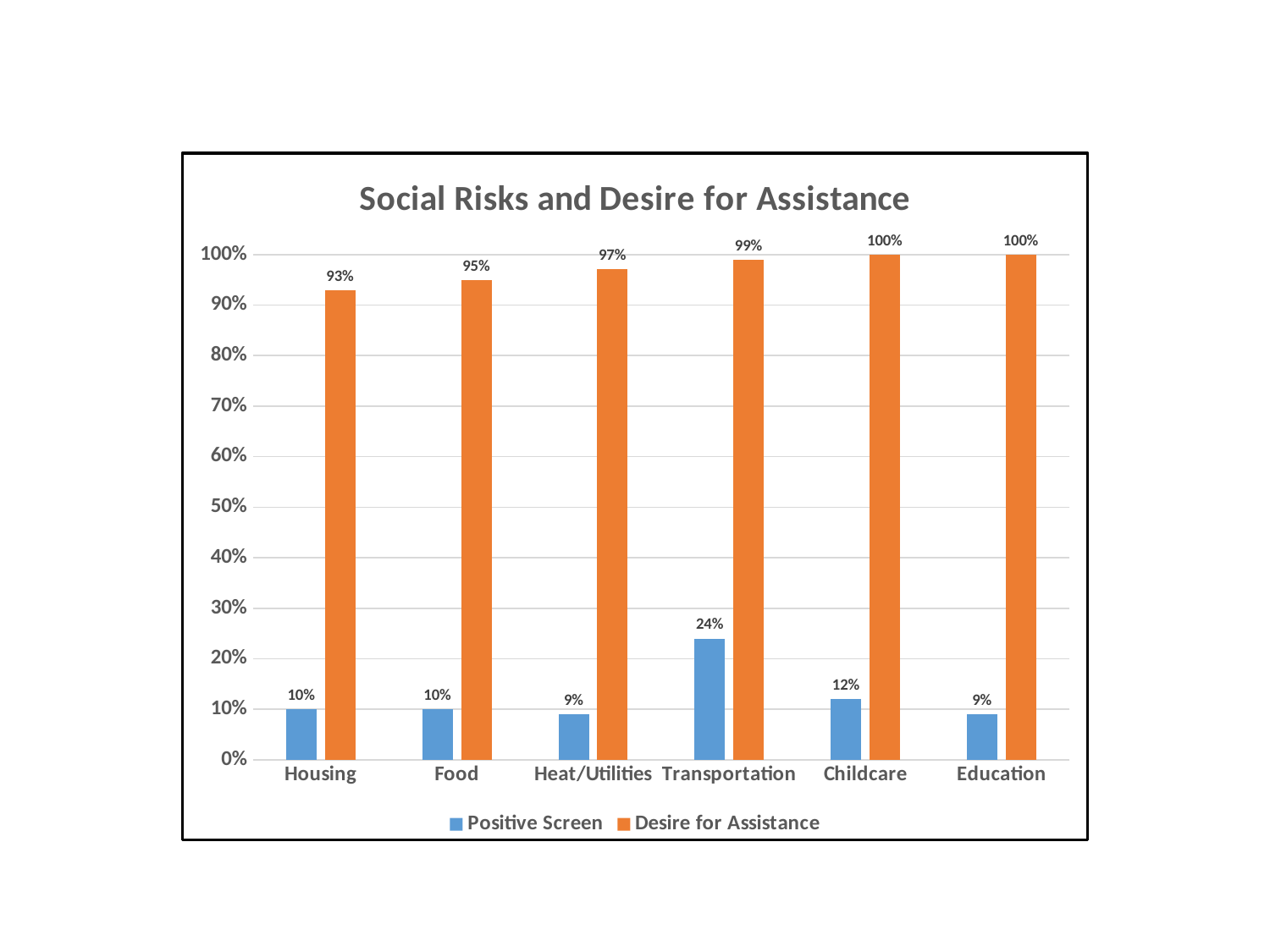
What kind of chart is shown? Bar chart What is the Desire for Assistance value for Housing? 93% How many categories are shown on the x axis? 6 How many series does the legend list? 2 Which category has the lowest Desire for Assistance value? Housing What is the difference between the Desire for Assistance and Positive Screen values for Food? 85% Which is larger, the Positive Screen value for Childcare or for Education? Childcare Which category has the highest Positive Screen value? Transportation Which colour represents the Desire for Assistance series? Orange What is the title of the chart? Social Risks and Desire for Assistance What is the Positive Screen value for Transportation? 24% What is the Positive Screen value for Childcare? 12%